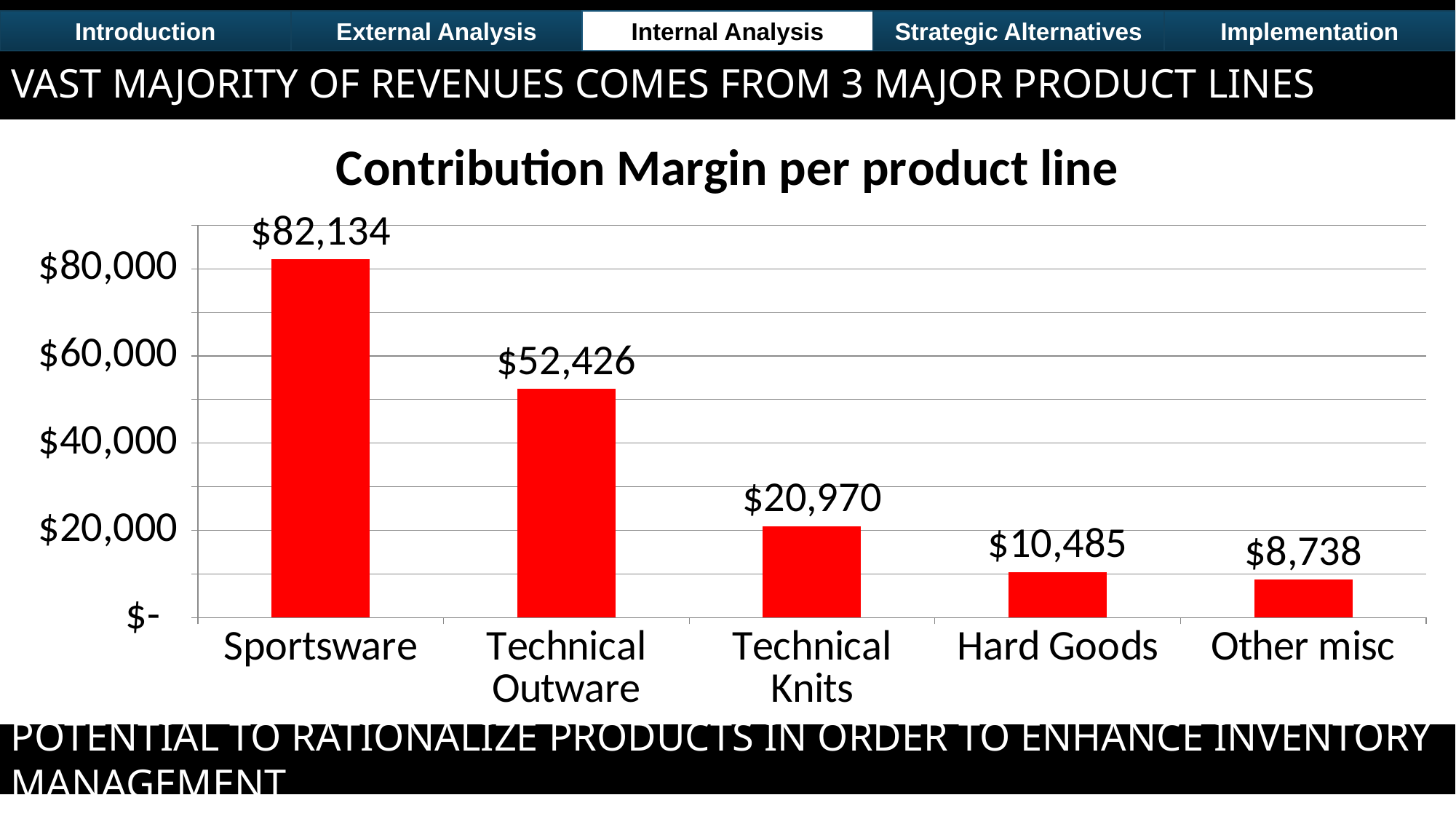
What is the contribution margin for Technical Outware? $52,426 What is the contribution margin for Hard Goods? $10,485 Is the contribution margin for Technical Outware greater or less than $40,000? greater How many product lines are shown in the chart? 5 Which has a larger contribution margin, Technical Knits or Other misc? Technical Knits Which product line has the lowest contribution margin? Other misc What kind of chart is shown on the slide? Bar chart Which product line has the highest contribution margin? Sportsware What is the difference between the contribution margins of Sportsware and Technical Outware? $29,708 What is the difference between the contribution margins of Technical Knits and Hard Goods? $10,485 What is the contribution margin for Sportsware? $82,134 What is the title of the chart? Contribution Margin per product line